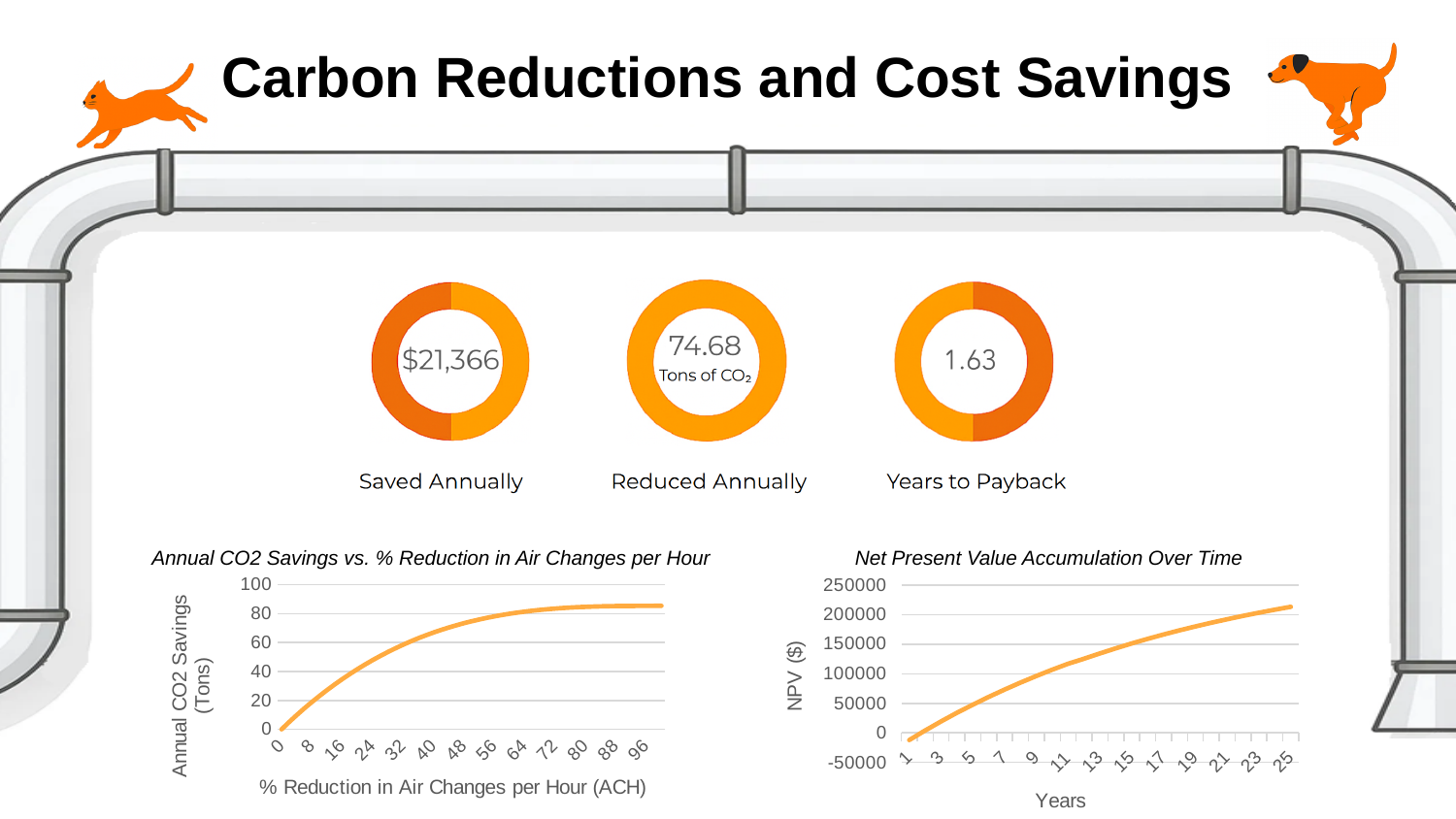
In the 'Annual CO2 Savings vs. % Reduction in Air Changes per Hour' chart, is the value at 96% reduction greater or less than 80? greater In the 'Annual CO2 Savings vs. % Reduction in Air Changes per Hour' chart, is the value at 48% reduction greater or less than 60? greater On the 'Saved Annually' donut chart, what value is shown in the centre? $21,366 In the 'Net Present Value Accumulation Over Time' chart, does NPV rise or fall over the years? rise What kind of chart is 'Net Present Value Accumulation Over Time'? line chart In the 'Annual CO2 Savings vs. % Reduction in Air Changes per Hour' chart, do the values rise or fall as the % reduction increases? rise In the 'Net Present Value Accumulation Over Time' chart, is the NPV at year 5 greater or less than 100000? less What kind of chart is 'Annual CO2 Savings vs. % Reduction in Air Changes per Hour'? line chart On the 'Reduced Annually' donut chart, how many tons of CO2 are shown? 74.68 On the 'Years to Payback' donut chart, what value is shown in the centre? 1.63 What is the y-axis title of the 'Net Present Value Accumulation Over Time' chart? NPV ($)